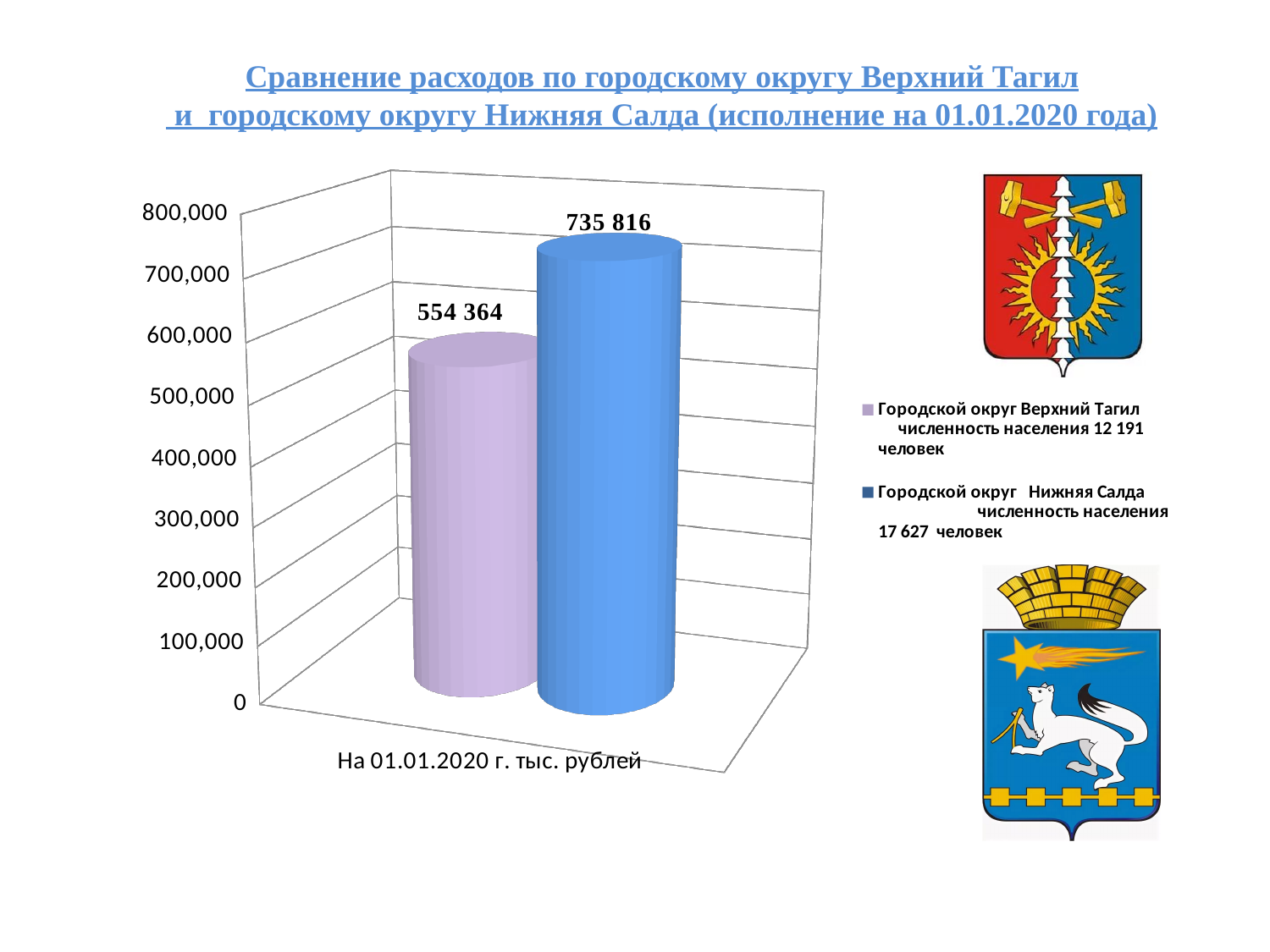
What is the difference between the values for Нижняя Салда and Верхний Тагил? 181 452 What population figure does the legend give for Городской округ Нижняя Салда? 17 627 человек What is the value shown for Городской округ Нижняя Салда? 735 816 What is the value shown for Городской округ Верхний Тагил? 554 364 Is the value for Верхний Тагил larger or smaller than the value for Нижняя Салда? smaller Which of the two городских округов has the higher expenditure value? Городской округ Нижняя Салда Is the value for Нижняя Салда greater or less than 700,000? greater What kind of chart is shown on the slide? bar chart How many bars are plotted on the chart? 2 Which of the two городских округов has the lower expenditure value? Городской округ Верхний Тагил How many series does the legend list? 2 Is the value for Верхний Тагил greater or less than 600,000? less